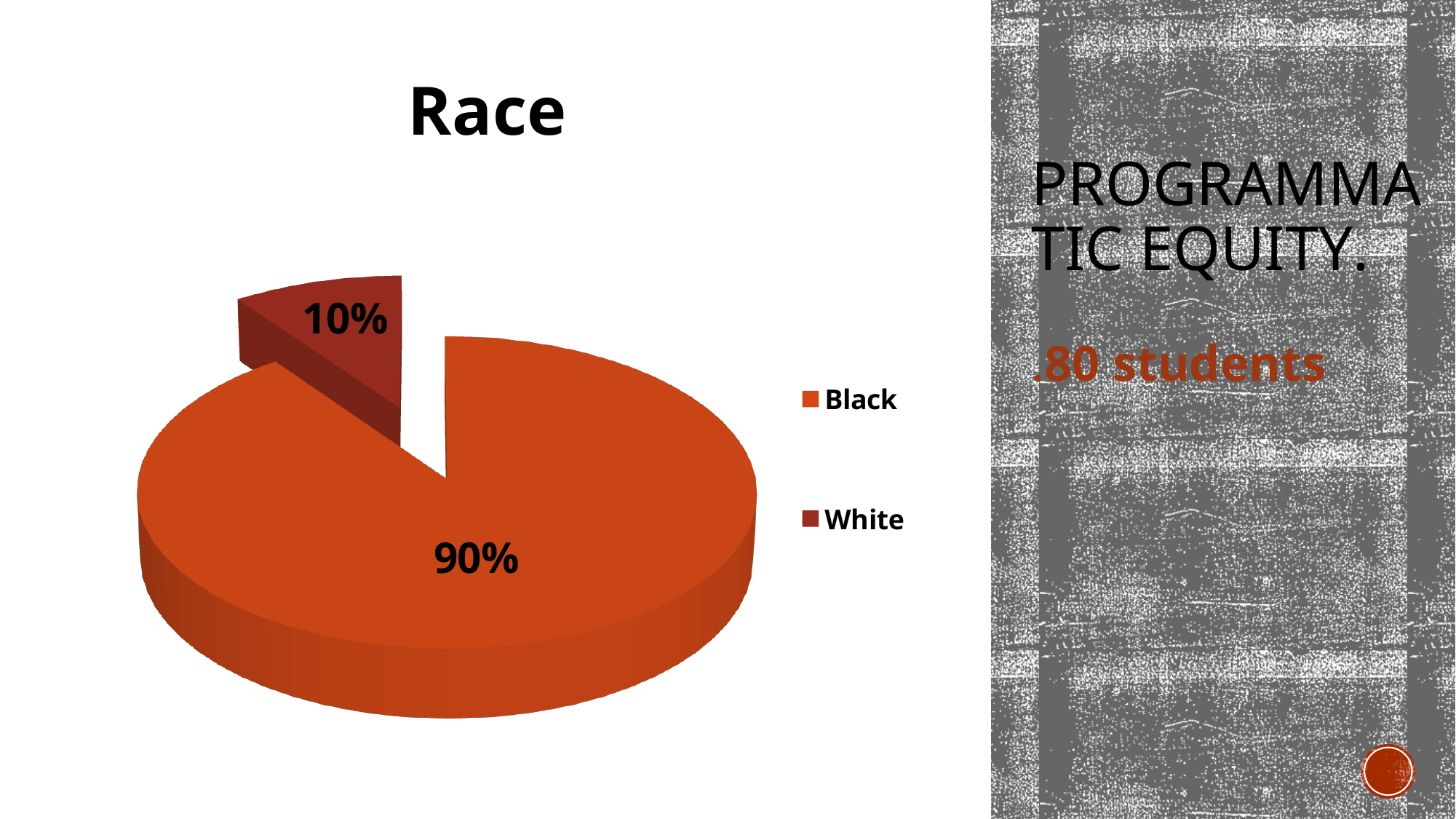
What is the difference in percentage points between the Black and White slices? 80 What is the title of the chart? Race What are the two legend entries of the chart? Black and White Which category has the largest slice of the pie? Black Which category has the smallest slice of the pie? White What share of the pie does the White slice represent? 10% Which is larger, the Black slice or the White slice? Black What kind of chart is shown on the slide? pie chart What share of the pie does the Black slice represent? 90% How many categories does the pie chart show? 2